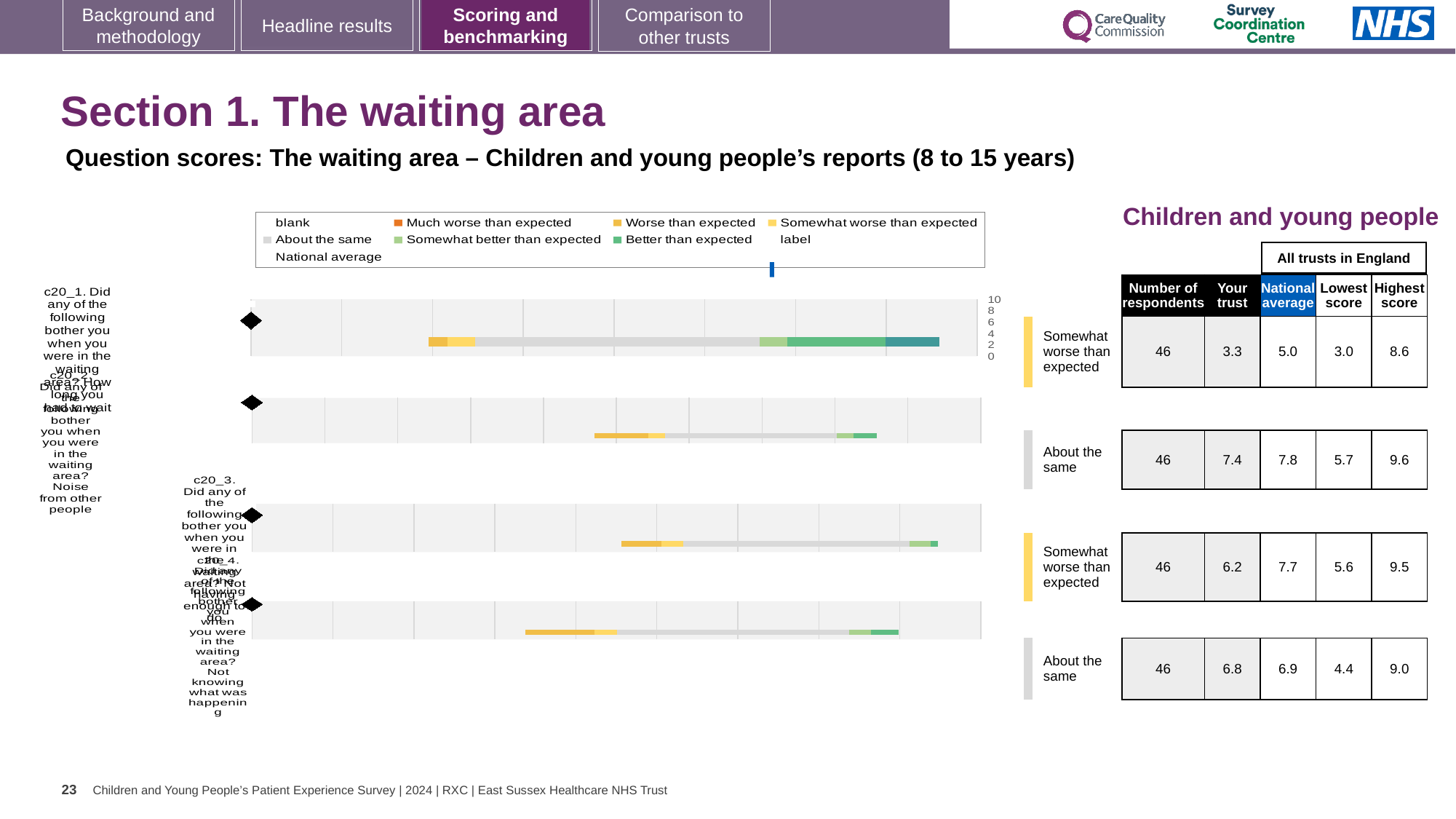
In the table, what is the 'Your trust' score for the second question (c20_2, noise from other people)? 7.4 In the chart legend, what label is shown for the dark blue marker? National average In the chart legend, which colour represents 'Much worse than expected'? orange How many separate question-score charts are shown on the slide? 4 In the table, how many respondents are listed for each question? 46 In the table, what is the lowest score across all trusts in England for the fourth question (c20_4, not knowing what was happening)? 4.4 In the table, which is larger for the fourth question (c20_4): the 'Your trust' score or the national average? National average What kind of chart is used to show the question scores on this slide? bar chart In the table, what is the 'Your trust' score for the first question (c20_1, how long you had to wait)? 3.3 In the table, what is the 'Your trust' score for the third question (c20_3, not having enough to do)? 6.2 In the table, what is the highest score across all trusts in England for the second question (c20_2)? 9.6 In the table, what is the national average for the first question (c20_1)? 5.0